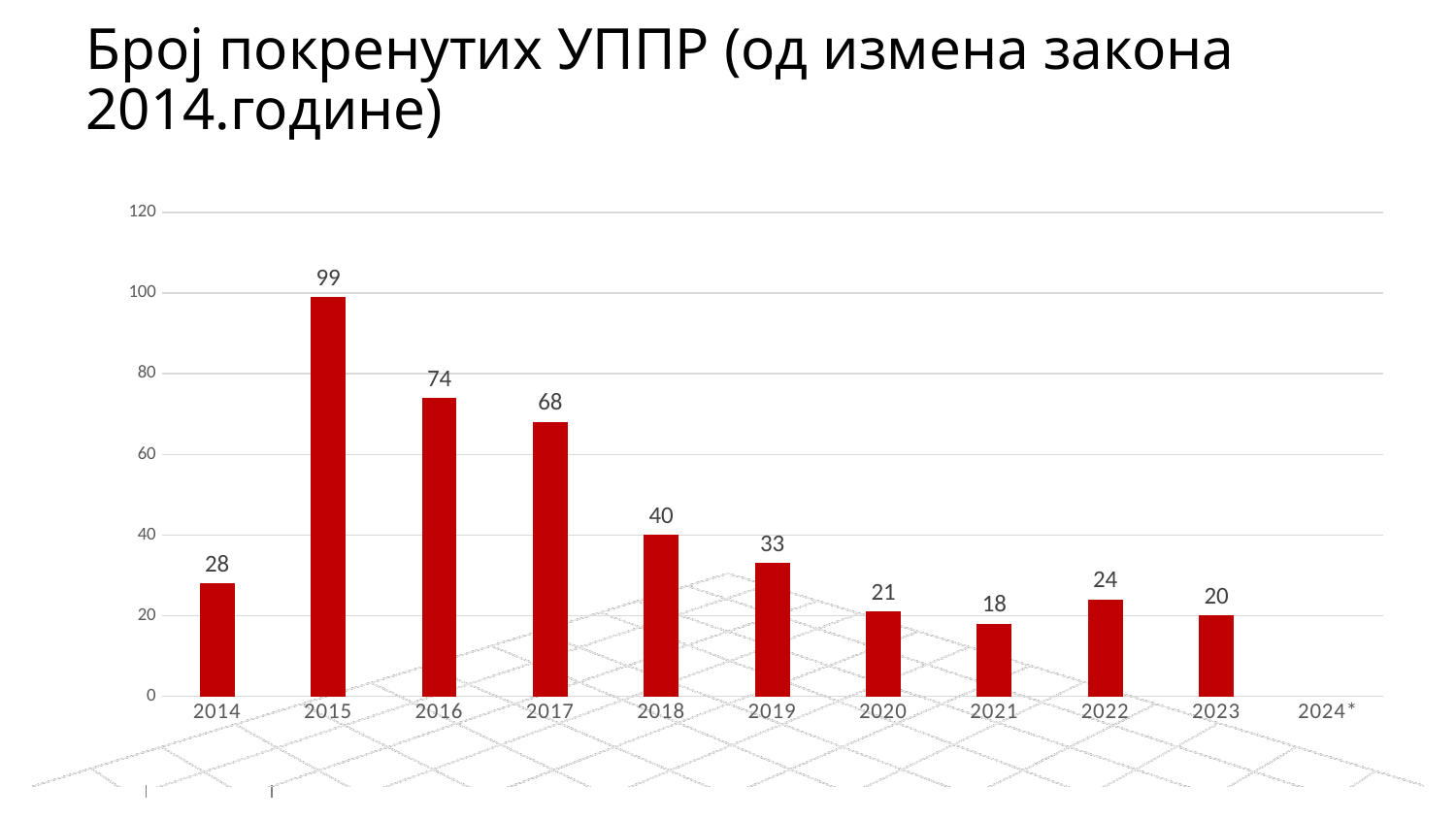
Which year has the highest value? 2015 What is the difference between the values for 2015 and 2014? 71 What is the value for 2018? 40 What is the value for 2015? 99 Do the values generally rise or fall from 2015 to 2021? fall Which year with a plotted bar has the lowest value? 2021 Which is larger, the value for 2022 or the value for 2023? 2022 Is the value for 2019 greater or less than 40? less What is the value for 2021? 18 How many bars are plotted on the chart? 10 What is the difference between the values for 2016 and 2017? 6 What kind of chart is shown on the slide? bar chart